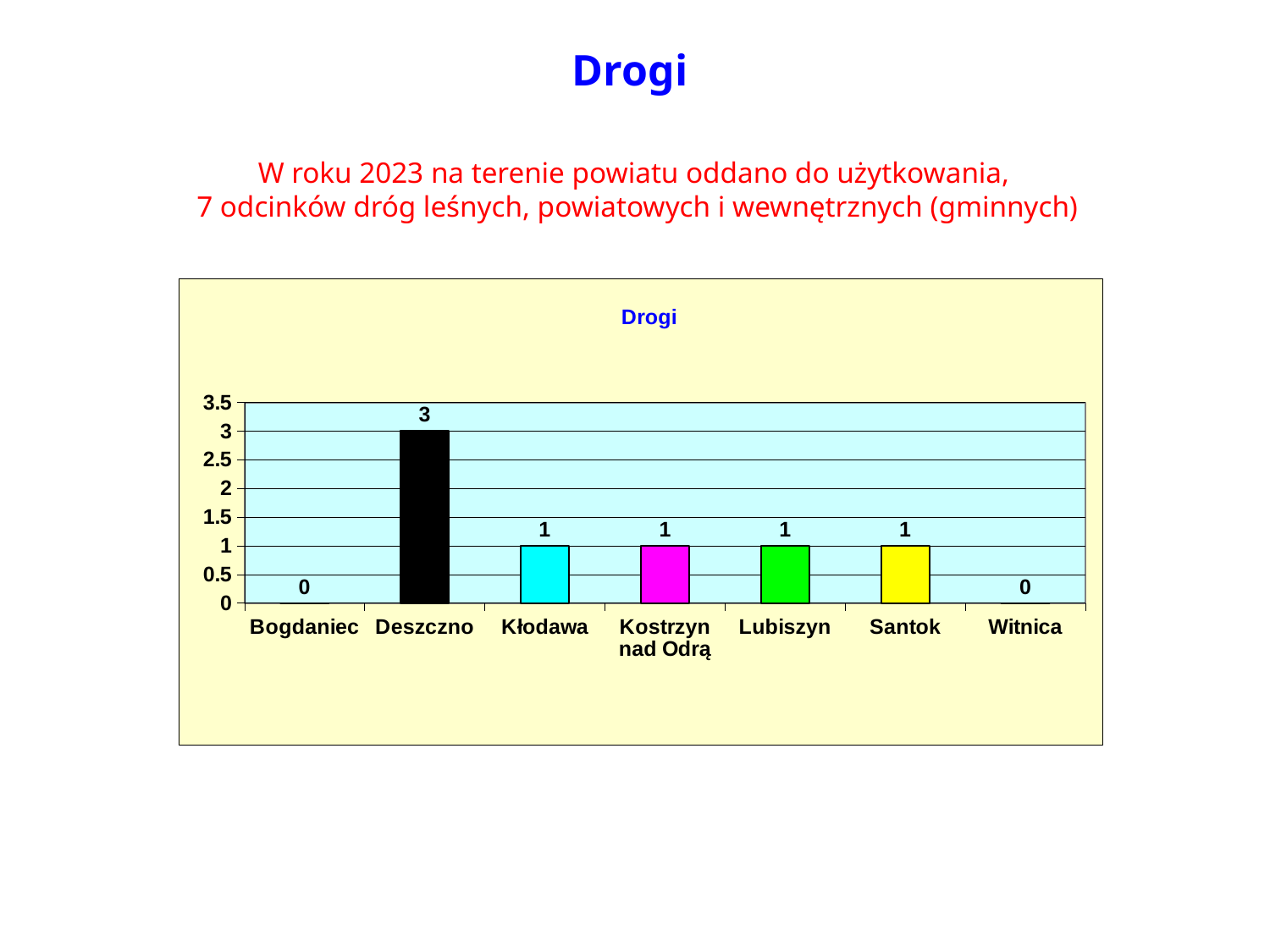
What is the value for Bogdaniec? 0 Which is larger, the value for Deszczno or the value for Lubiszyn? Deszczno What is the value for Deszczno? 3 What colour is the bar for Deszczno? black Which category has the highest value? Deszczno What is the title of the chart? Drogi What is the value for Kłodawa? 1 Is the value for Deszczno greater or less than 2? greater What is the value for Witnica? 0 What kind of chart is shown? bar chart How many categories are shown on the x axis? 7 What is the difference between the values for Deszczno and Santok? 2